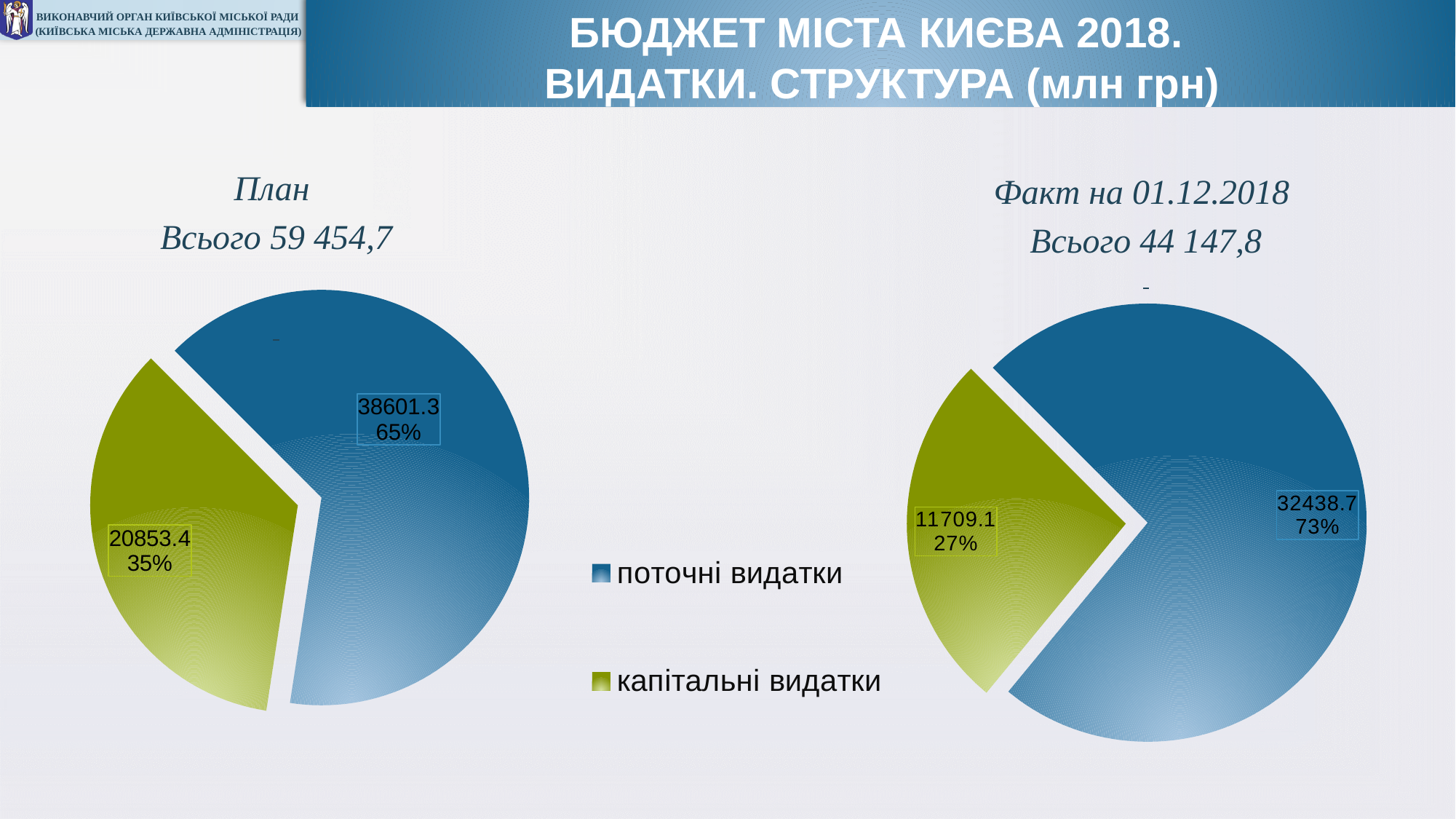
In the left chart (План), what is the value for поточні видатки? 38601.3 In the left chart (План), what is the value for капітальні видатки? 20853.4 In the right chart (Факт на 01.12.2018), which category is the largest? поточні видатки In the left chart (План), which category is the smallest? капітальні видатки In the right chart (Факт на 01.12.2018), what is the value for капітальні видатки? 11709.1 In the right chart (Факт на 01.12.2018), what is the value for поточні видатки? 32438.7 How many series does the legend list? 2 In the left chart (План), what share of the pie is капітальні видатки? 35% In the left chart (План), what is the difference between поточні видатки and капітальні видатки? 17747.9 In the right chart (Факт на 01.12.2018), what share of the pie is поточні видатки? 73% Which is larger: капітальні видатки in the left chart (План) or капітальні видатки in the right chart (Факт на 01.12.2018)? План What type of chart is used on this slide? Pie chart